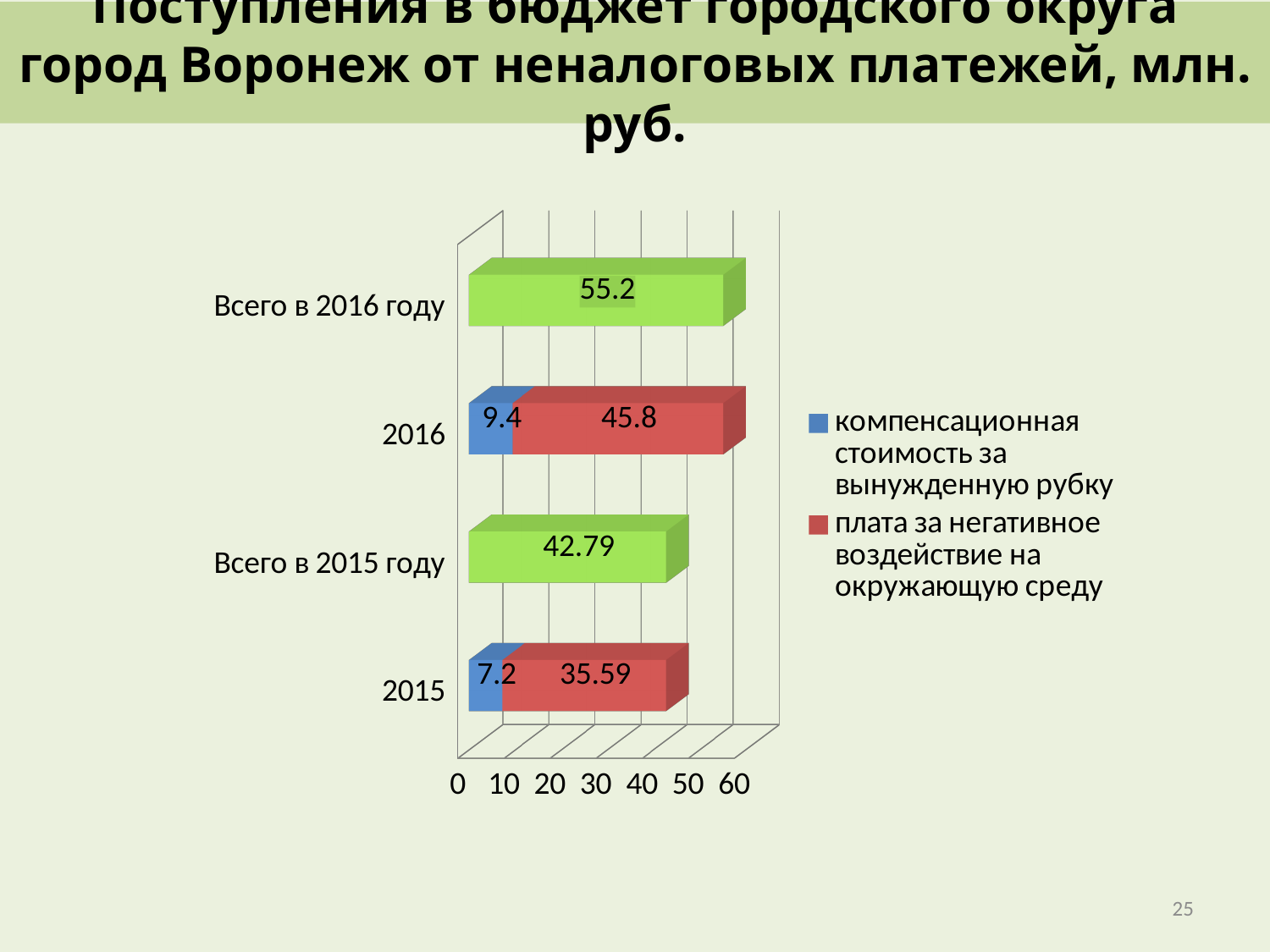
What value is shown for 'Всего в 2015 году'? 42.79 What is the value of the 'плата за негативное воздействие на окружающую среду' series for 2015? 35.59 How many series does the legend list? 2 What is the difference between the 'плата за негативное воздействие на окружающую среду' values for 2016 and 2015? 10.21 What is the value of the 'плата за негативное воздействие на окружающую среду' series for 2016? 45.8 What is the value of the 'компенсационная стоимость за вынужденную рубку' series for 2016? 9.4 What is the unit of measurement stated in the chart title? млн. руб. Which is larger: the 'компенсационная стоимость за вынужденную рубку' value for 2016 or for 2015? 2016 What is the difference between the totals for 2016 and 2015 ('Всего в 2016 году' minus 'Всего в 2015 году')? 12.41 What value is shown for 'Всего в 2016 году'? 55.2 What kind of chart is shown on the slide? Bar chart Which category has the highest value on the chart? Всего в 2016 году